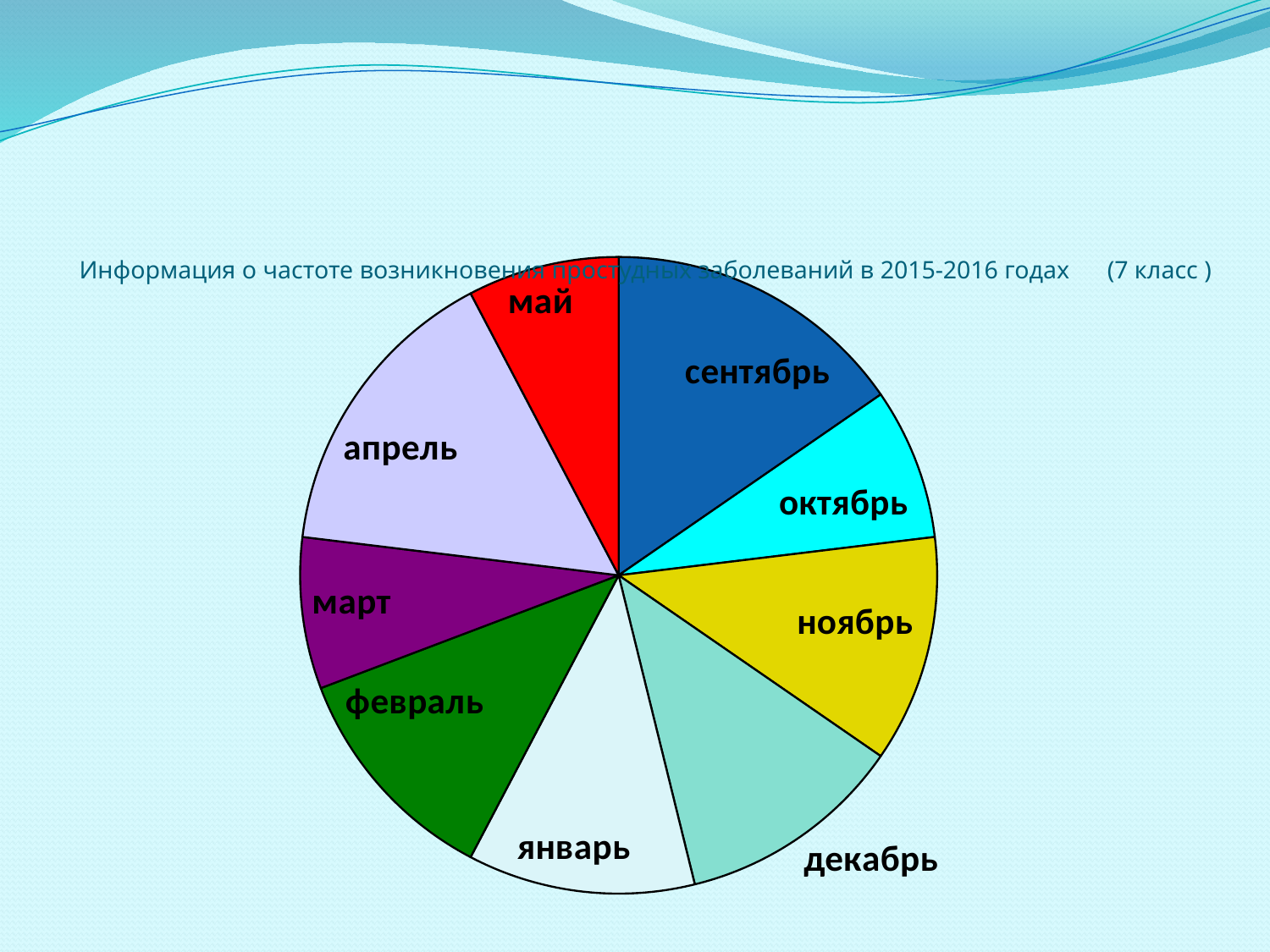
Which slice is larger, март or январь? январь Which slice is larger, апрель or май? апрель Which slice is larger, май or декабрь? декабрь Which month's slice is coloured yellow? ноябрь How many slices does the pie chart have? 9 What colour is the май slice? red What kind of chart is shown on the slide? pie chart